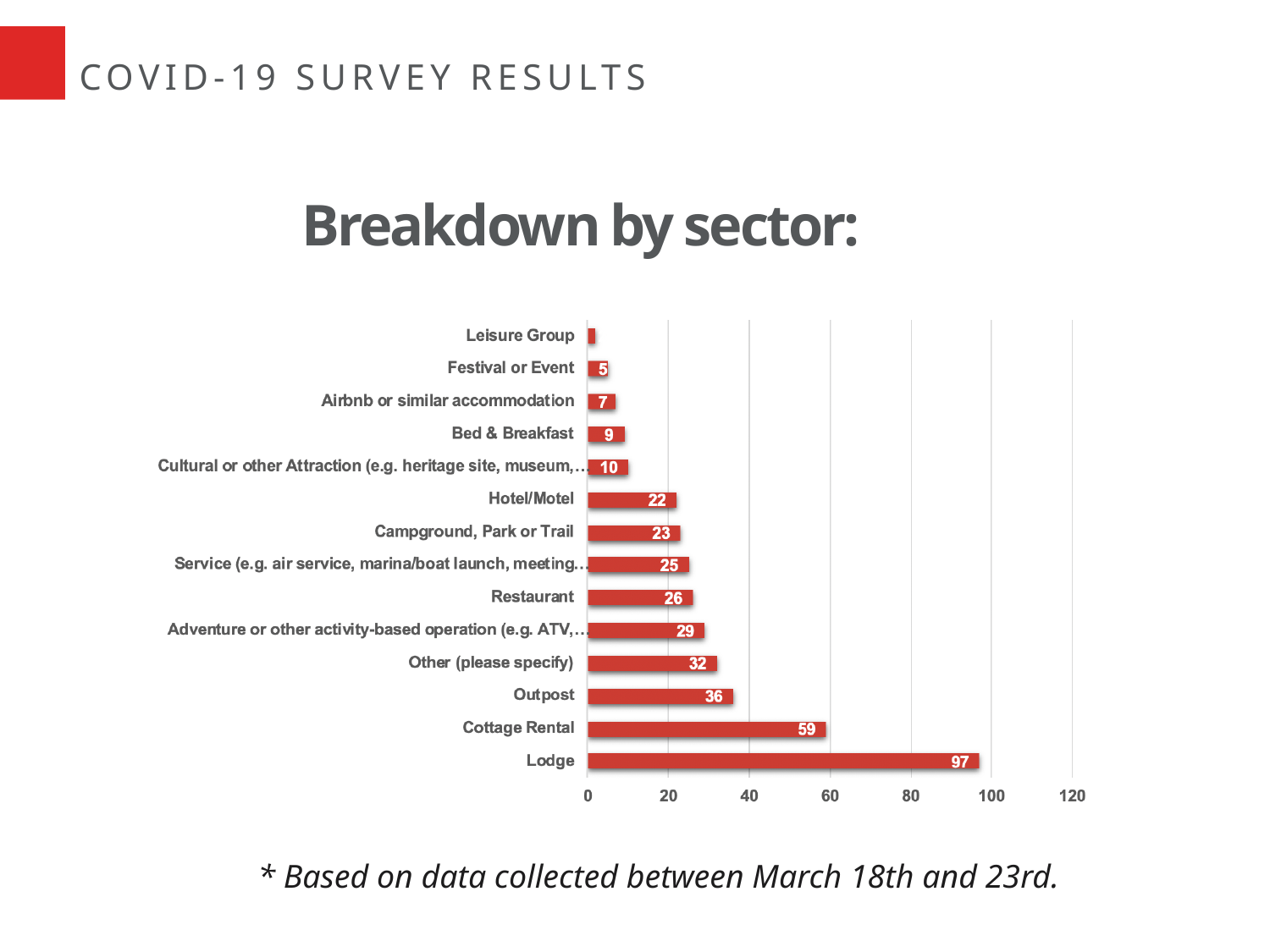
Is the value for Leisure Group greater or less than 20? less What kind of chart is shown on the slide? bar chart What is the value for Lodge? 97 What is the value for Cottage Rental? 59 Which sector has the lowest value? Leisure Group Which sector has the highest value? Lodge What is the value for Bed & Breakfast? 9 What is the difference between the values for Lodge and Cottage Rental? 38 Which is larger, the value for Outpost or the value for Restaurant? Outpost How many sectors are shown in the chart? 14 What is the title of the chart? Breakdown by sector: What is the value for Hotel/Motel? 22